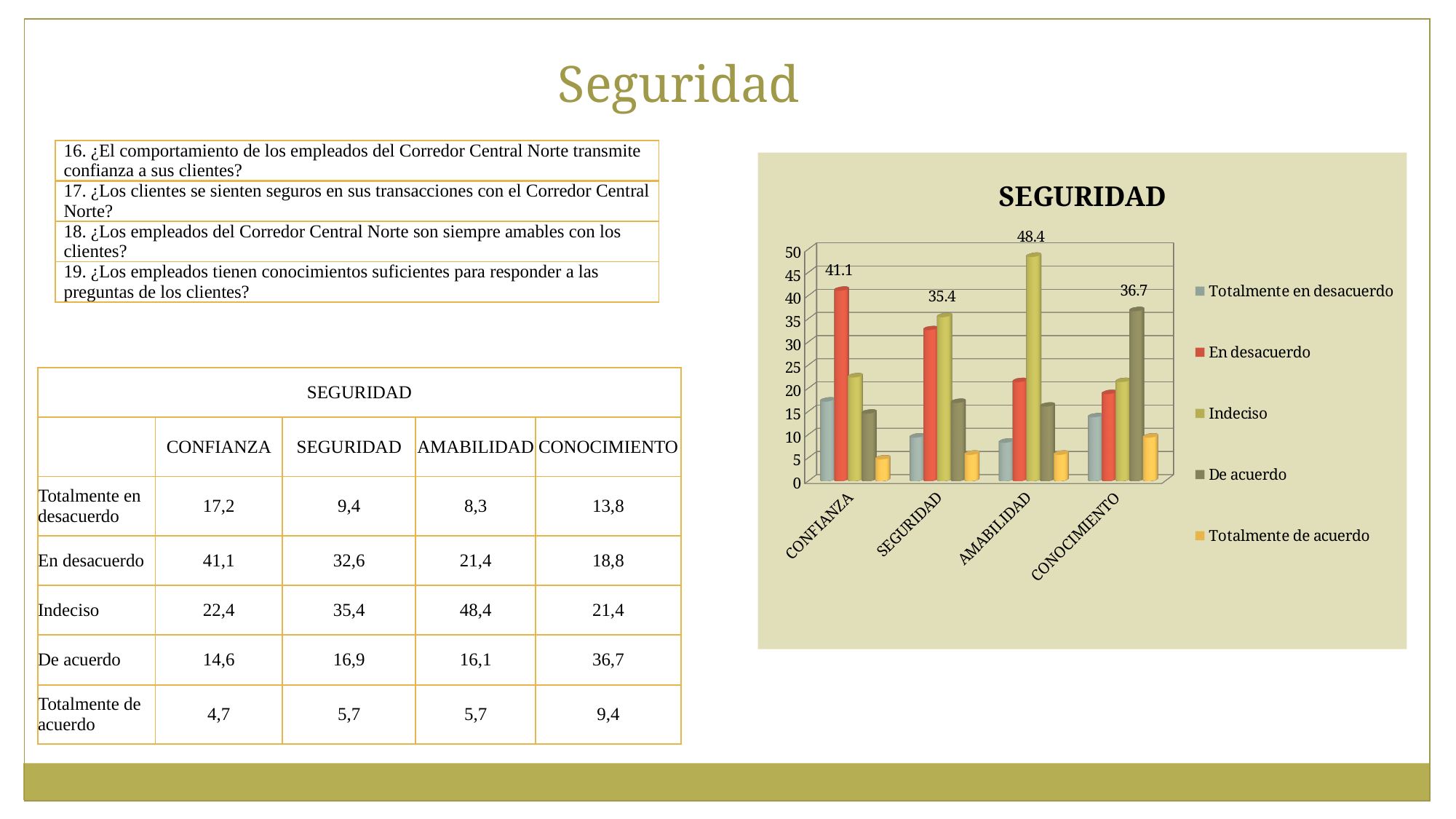
Is the value for Totalmente de acuerdo in the CONFIANZA category greater or less than 10? less What is the value labelled for De acuerdo in the CONOCIMIENTO category? 36.7 What is the value labelled for Indeciso in the AMABILIDAD category? 48.4 Which category has the tallest bar in the chart? AMABILIDAD How many series does the legend of the SEGURIDAD chart list? 5 What kind of chart is shown on the slide? bar chart What is the title of the chart? SEGURIDAD What is the value labelled for Indeciso in the SEGURIDAD category? 35.4 What is the value labelled for En desacuerdo in the CONFIANZA category? 41.1 What is the difference between the labelled Indeciso value for AMABILIDAD and the labelled Indeciso value for SEGURIDAD? 13.0 Which is larger: the labelled value for En desacuerdo in CONFIANZA or the labelled value for De acuerdo in CONOCIMIENTO? En desacuerdo in CONFIANZA How many categories are shown on the x axis of the SEGURIDAD chart? 4